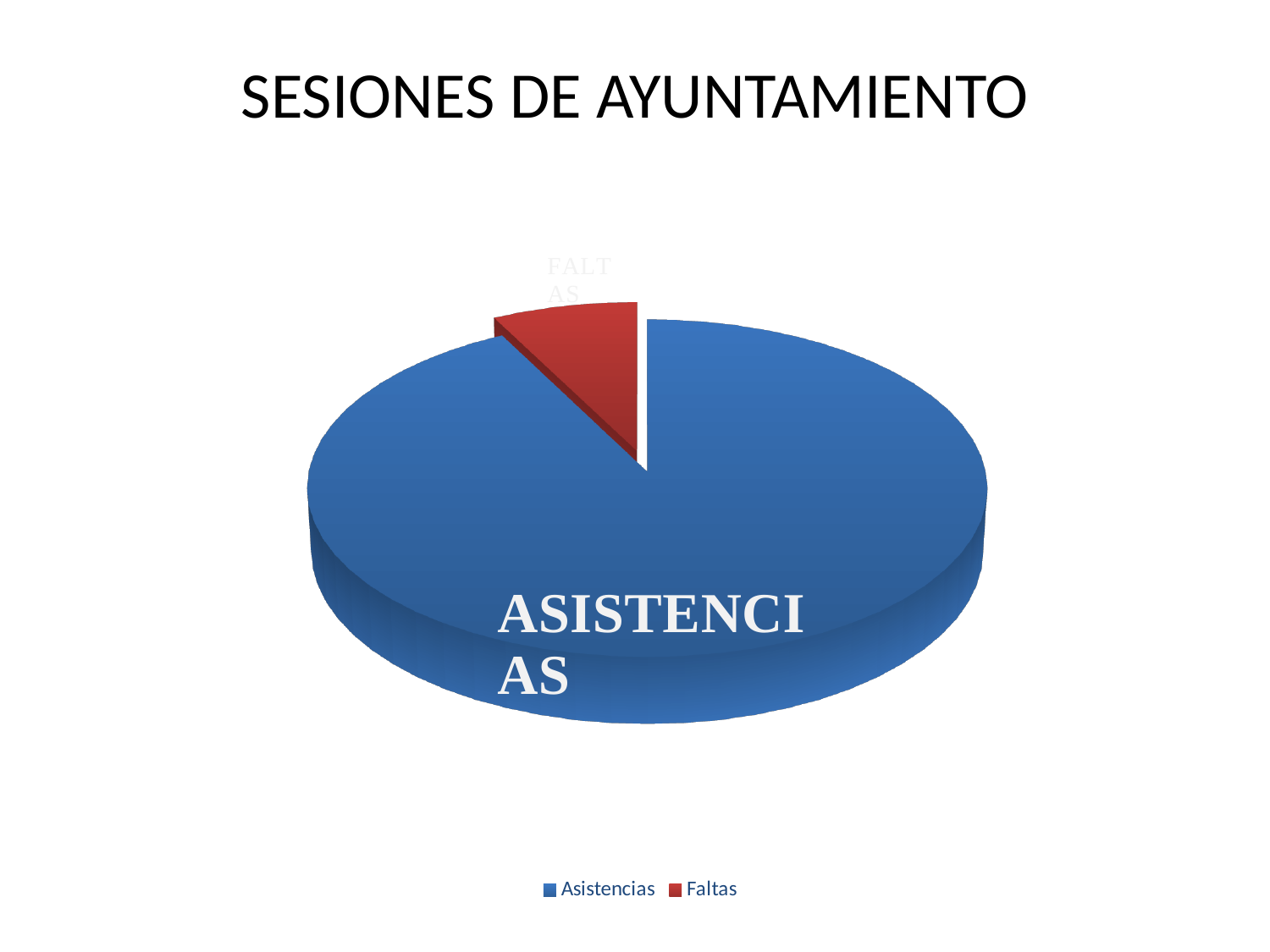
How many entries does the legend list? 2 Which category has the smallest slice of the pie? Faltas Which category has the largest slice of the pie? Asistencias What is the title of the slide containing the pie chart? SESIONES DE AYUNTAMIENTO What colour is the Faltas slice in the pie chart? red Which is larger, the slice for Asistencias or the slice for Faltas? Asistencias What kind of chart is shown on the slide? pie chart How many slices does the pie chart have? 2